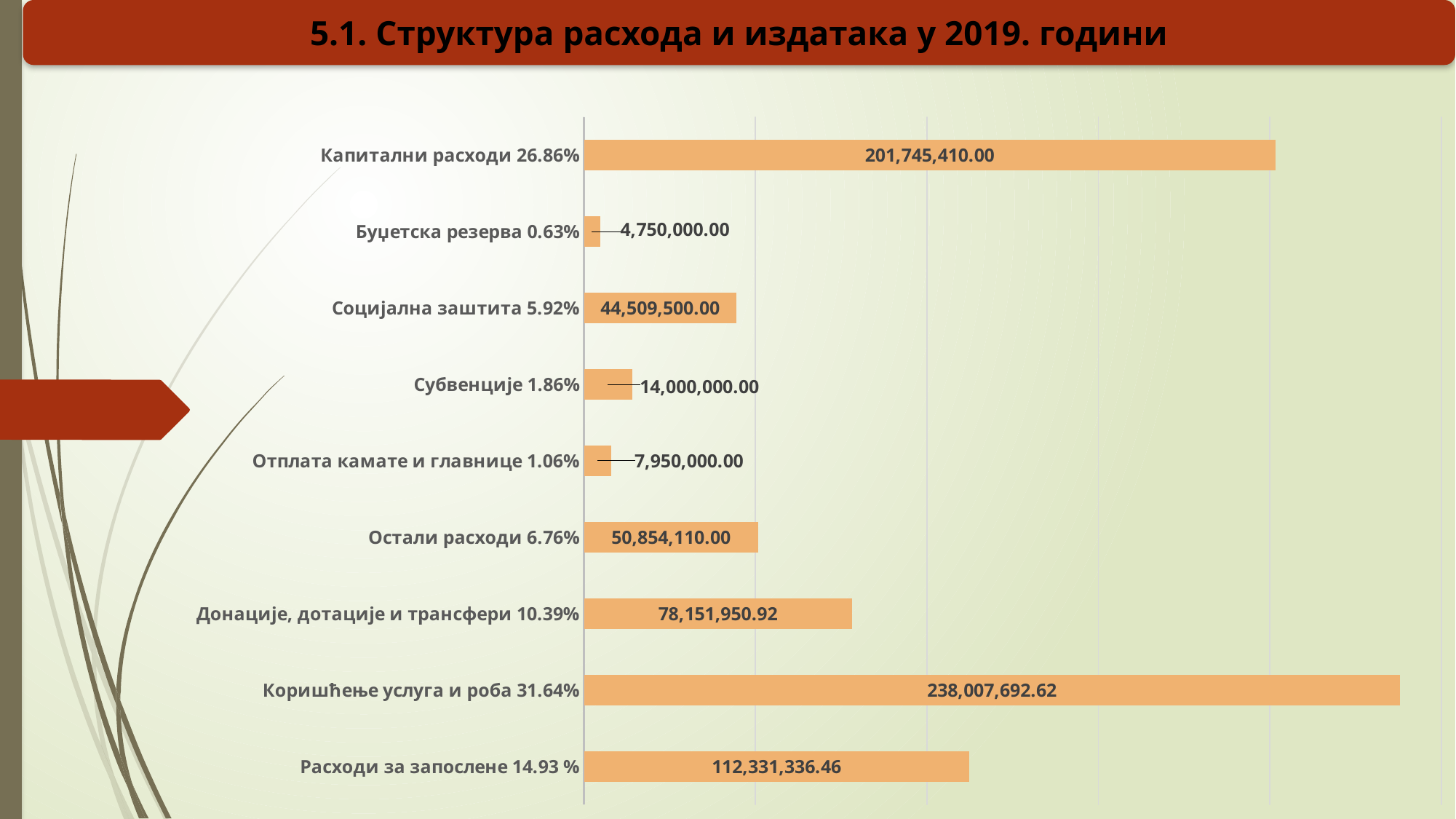
What is the value shown for Буџетска резерва? 4,750,000.00 What is the value shown for Донације, дотације и трансфери? 78,151,950.92 How many categories are shown in the chart? 9 What kind of chart is shown on the slide? Bar chart What is the difference between the values for Коришћење услуга и роба and Капитални расходи? 36,262,282.62 Which is larger, the value for Остали расходи or the value for Социјална заштита? Остали расходи Which category has the highest value? Коришћење услуга и роба What is the value shown for Капитални расходи? 201,745,410.00 What percentage share is printed next to the label Коришћење услуга и роба? 31.64% What is the difference between the values for Субвенције and Отплата камате и главнице? 6,050,000.00 What is the value shown for Расходи за запослене? 112,331,336.46 Which category has the lowest value? Буџетска резерва